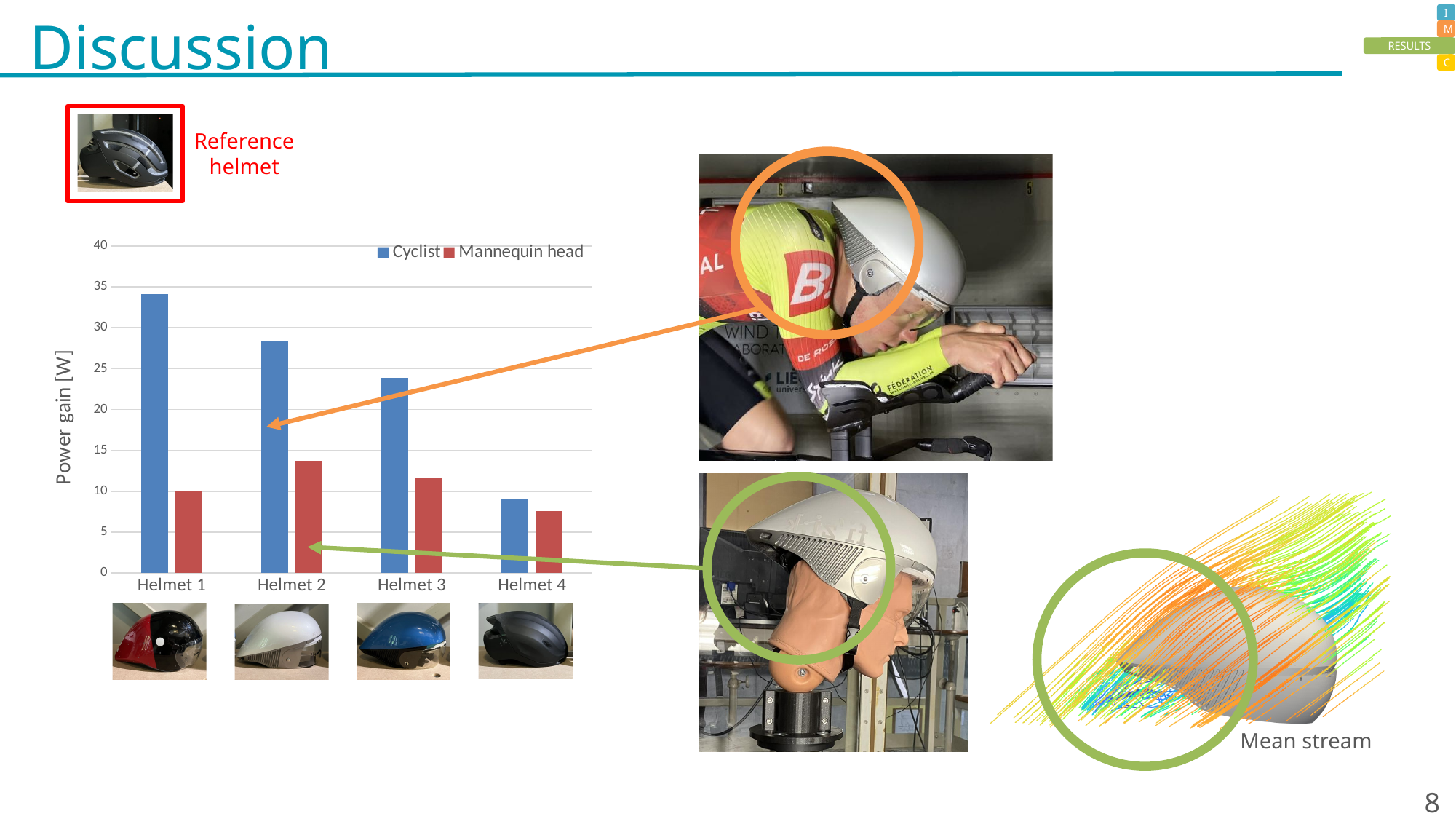
What is the label of the chart's y axis? Power gain [W] Is the Cyclist power gain for Helmet 4 greater or less than 10? less What kind of chart is shown on the slide? bar chart Which helmet has the lowest Mannequin head power gain? Helmet 4 How many series does the chart legend list? 2 How many helmet categories are shown on the x axis of the chart? 4 Which helmet has the highest Cyclist power gain? Helmet 1 Which helmet has the lowest Cyclist power gain? Helmet 4 For Helmet 3, which series has the larger power gain, Cyclist or Mannequin head? Cyclist Is the Cyclist power gain for Helmet 1 greater or less than 30? greater Do the Cyclist power gain values rise or fall from Helmet 1 to Helmet 4? fall Which helmet has the highest Mannequin head power gain? Helmet 2